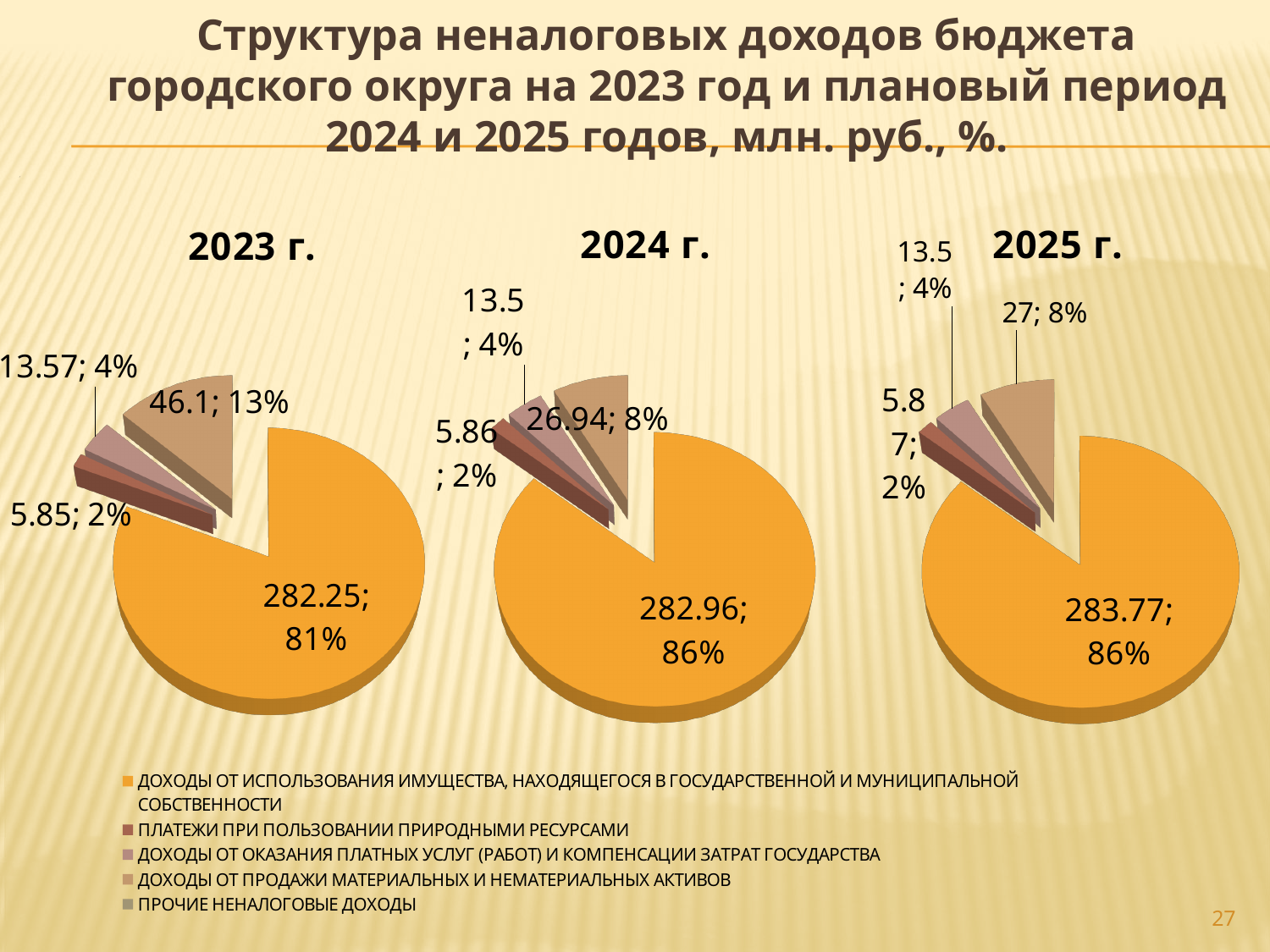
In the 2023 г. pie chart, which category has the smallest slice? Платежи при пользовании природными ресурсами (5.85; 2%) What type of chart is used on this slide for each year? Pie chart What colour is used for доходы от использования имущества, находящегося в государственной и муниципальной собственности in the pie charts? Orange In the 2025 г. pie chart, what value is shown for доходы от продажи материальных и нематериальных активов? 27; 8% In the 2023 г. pie chart, what is the difference between the slice labelled 46.1 and the slice labelled 13.57? 32.53 Which is larger: the доходы от продажи материальных и нематериальных активов slice in 2023 г. (46.1) or in 2024 г. (26.94)? 2023 г. (46.1) How many entries does the legend list? 5 In the 2024 г. pie chart, what share does the largest slice (доходы от использования имущества) have? 86% How many pie charts are shown on the slide? 3 In the 2025 г. pie chart, what share does доходы от оказания платных услуг have? 4% In the 2023 г. pie chart, what value is shown for the largest slice (доходы от использования имущества)? 282.25; 81% In the 2024 г. pie chart, what value is shown for платежи при пользовании природными ресурсами? 5.86; 2%